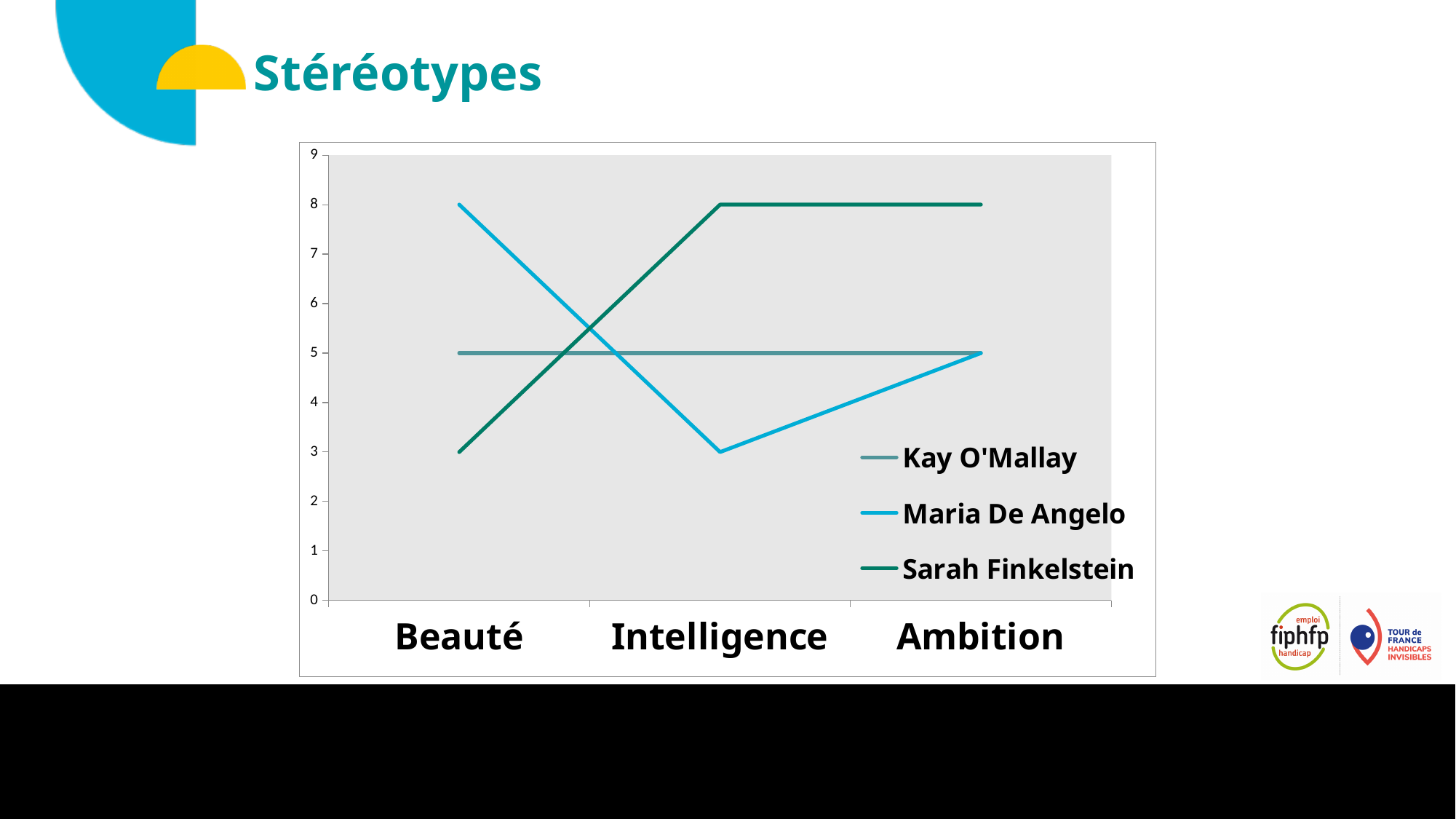
What is the value for Sarah Finkelstein at Beauté? 3 What kind of chart is shown on the slide? line chart What is the value for Maria De Angelo at Intelligence? 3 Which series has the highest value at Ambition? Sarah Finkelstein How many categories are shown on the x axis? 3 What is the value for Kay O'Mallay at Intelligence? 5 What is the value for Maria De Angelo at Beauté? 8 What is the title of the slide containing the chart? Stéréotypes What is the difference between Sarah Finkelstein's value at Intelligence and Maria De Angelo's value at Intelligence? 5 How many series does the legend list? 3 Does Maria De Angelo's value rise or fall from Beauté to Intelligence? fall Which series has the lowest value at Beauté? Sarah Finkelstein